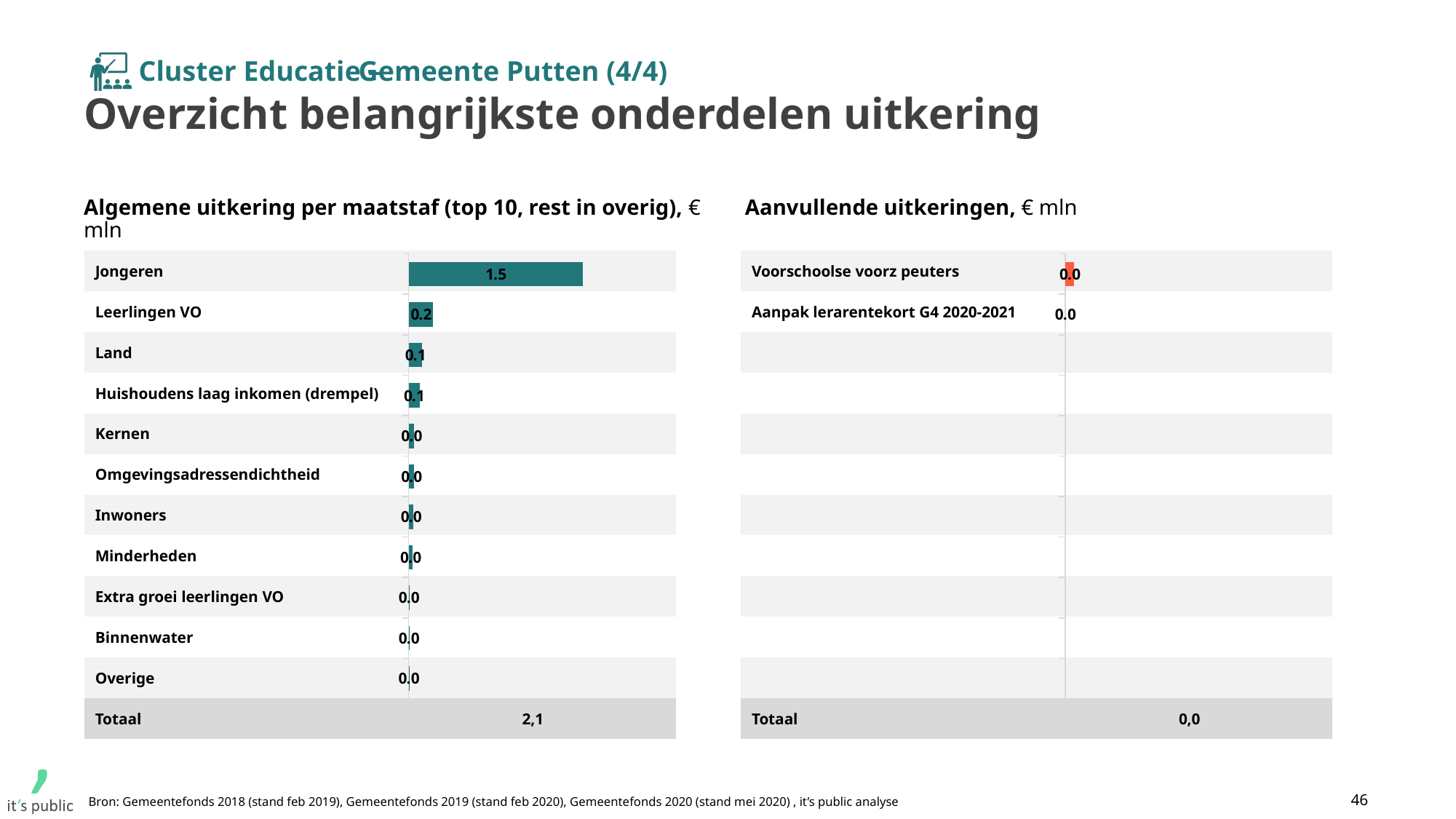
In the chart 'Algemene uitkering per maatstaf (top 10, rest in overig)', what is the difference between the values for Jongeren and Leerlingen VO? 1.3 What kind of chart is the 'Algemene uitkering per maatstaf' chart on the left? Bar chart In the chart 'Aanvullende uitkeringen', how many categories are shown (excluding the Totaal row)? 2 In the chart 'Algemene uitkering per maatstaf (top 10, rest in overig)', which is larger: the value for Jongeren or the value for Land? Jongeren In the chart 'Algemene uitkering per maatstaf (top 10, rest in overig)', how many categories are shown (excluding the Totaal row)? 11 In the chart 'Algemene uitkering per maatstaf (top 10, rest in overig)', what is the value for Jongeren? 1.5 In the chart 'Algemene uitkering per maatstaf (top 10, rest in overig)', what is the value for Land? 0.1 In the chart 'Aanvullende uitkeringen', what is the value shown in the Totaal row? 0,0 In the chart 'Algemene uitkering per maatstaf (top 10, rest in overig)', what is the value shown in the Totaal row? 2,1 In the chart 'Algemene uitkering per maatstaf (top 10, rest in overig)', which category has the highest value? Jongeren In the chart 'Aanvullende uitkeringen', what is the value for Voorschoolse voorz peuters? 0.0 In the chart 'Algemene uitkering per maatstaf (top 10, rest in overig)', what is the value for Leerlingen VO? 0.2